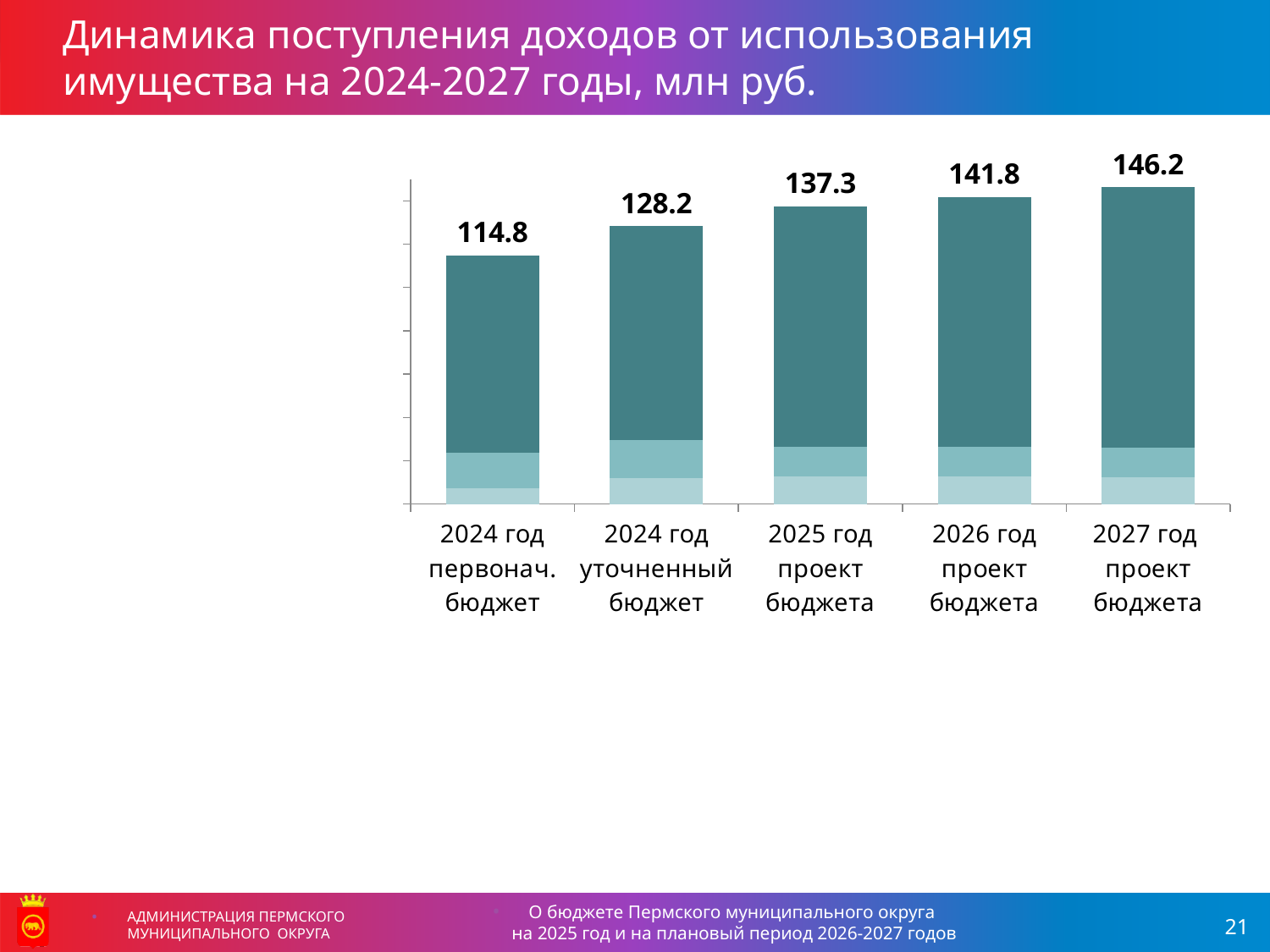
What is the total value shown for the 2025 год проект бюджета bar? 137.3 Which is larger: the total for 2024 год уточненный бюджет or the total for 2025 год проект бюджета? 2025 год проект бюджета What is the total value shown for the 2027 год проект бюджета bar? 146.2 Do the total values rise or fall from left to right along the x axis? Rise How many categories (bars) are shown on the chart? 5 What is the total value shown for the 2024 год уточненный бюджет bar? 128.2 What kind of chart is shown on the slide? Stacked bar chart Which category has the lowest total value? 2024 год первонач. бюджет What is the difference between the totals for 2026 год проект бюджета and 2025 год проект бюджета? 4.5 What is the total value shown for the 2024 год первонач. бюджет bar? 114.8 Which category has the highest total value? 2027 год проект бюджета What is the difference between the totals for 2027 год проект бюджета and 2024 год первонач. бюджет? 31.4